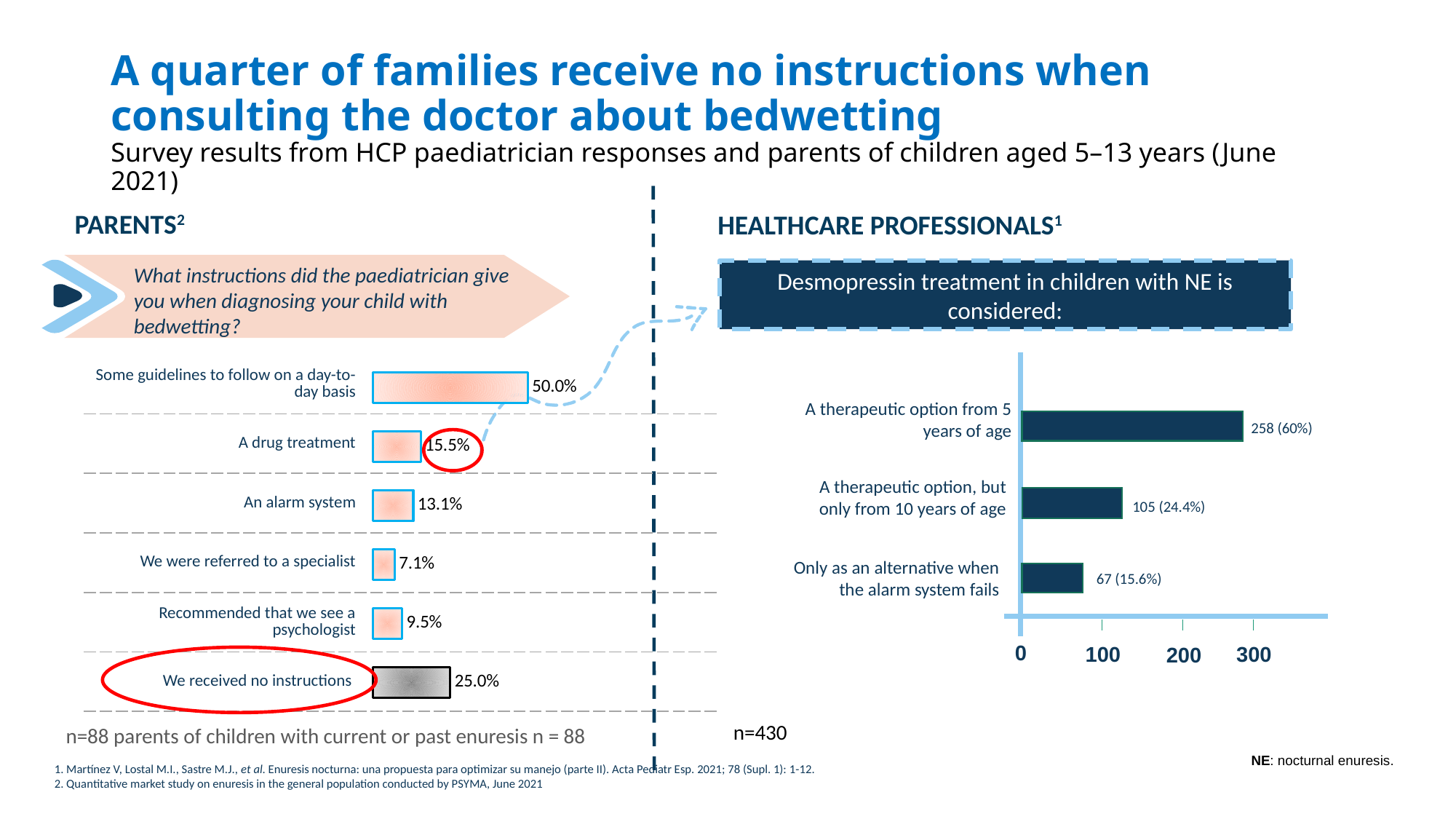
In the Healthcare Professionals chart, is the value for 'A therapeutic option, but only from 10 years of age' greater or less than 200? less In the Healthcare Professionals chart, what is the difference in respondent counts between 'A therapeutic option from 5 years of age' and 'A therapeutic option, but only from 10 years of age'? 153 How many instruction categories are shown in the Parents chart? 6 In the Parents chart, what percentage of parents said they were referred to a specialist? 7.1% In the Healthcare Professionals chart, how many respondents consider desmopressin a therapeutic option from 5 years of age? 258 (60%) In the Parents chart, what percentage of parents said they received no instructions? 25.0% In the Parents chart, what percentage of parents said the paediatrician gave some guidelines to follow on a day-to-day basis? 50.0% What type of chart is used in the Healthcare Professionals section? Bar chart In the Healthcare Professionals chart, what is the value for 'Only as an alternative when the alarm system fails'? 67 (15.6%) In the Parents chart, what is the difference in percentage points between 'A drug treatment' and 'An alarm system'? 2.4 In the Parents chart, which instruction category has the lowest percentage? We were referred to a specialist In the Parents chart, which is larger: 'Recommended that we see a psychologist' or 'We were referred to a specialist'? Recommended that we see a psychologist